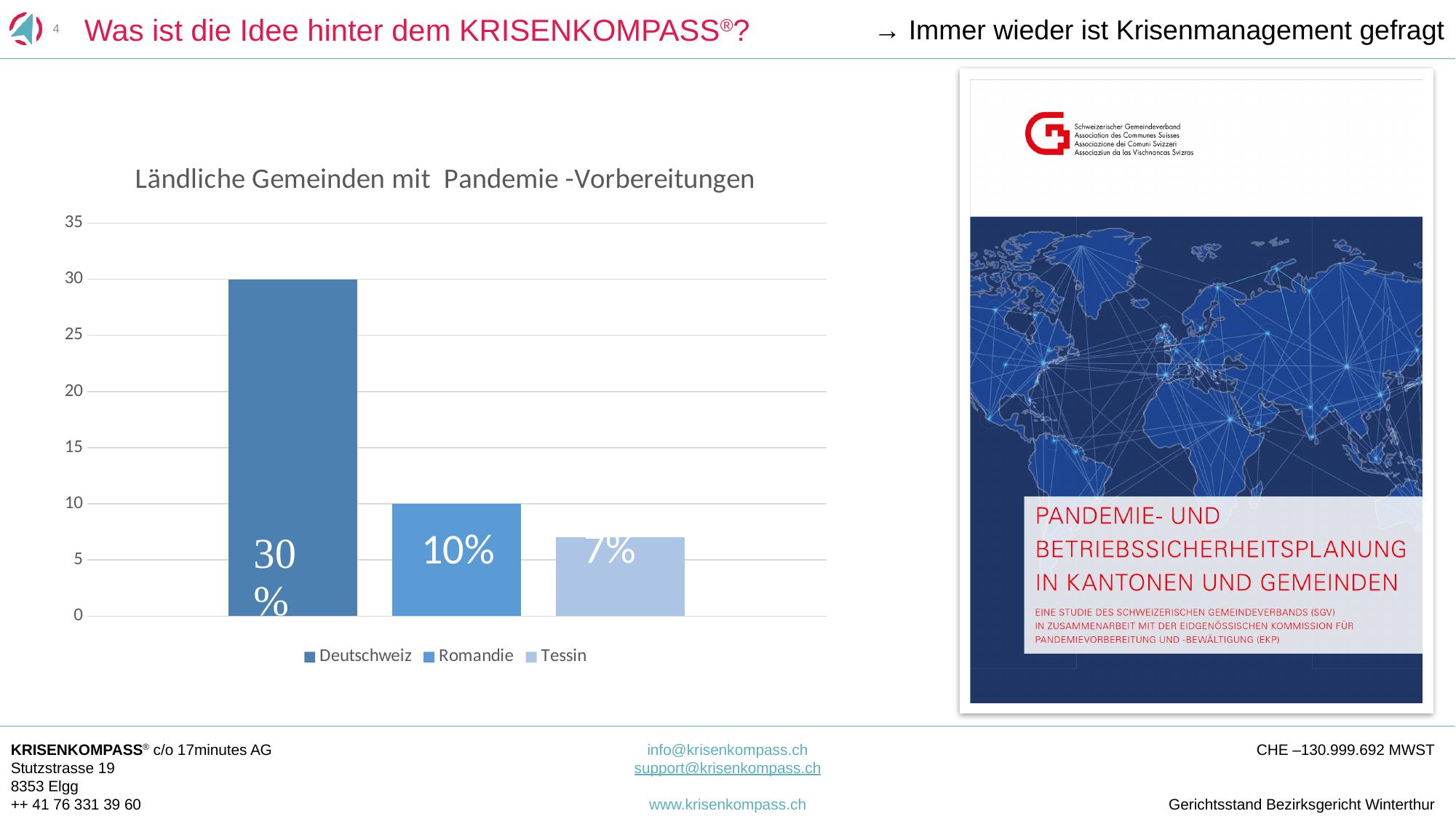
How many series does the legend of the chart list? 3 What is the title of the chart on the slide? Ländliche Gemeinden mit Pandemie -Vorbereitungen What is the value for Romandie in the chart? 10% What is the difference between the values for Romandie and Tessin? 3% What is the value for Deutschweiz in the chart "Ländliche Gemeinden mit Pandemie -Vorbereitungen"? 30% What is the value for Tessin in the chart? 7% Is the value for Deutschweiz greater or less than 25? greater Which region has the highest value in the chart? Deutschweiz Which is larger, the value for Romandie or the value for Tessin? Romandie Which region has the lowest value in the chart? Tessin What kind of chart is shown on the slide? Bar chart What is the difference between the values for Deutschweiz and Romandie? 20%